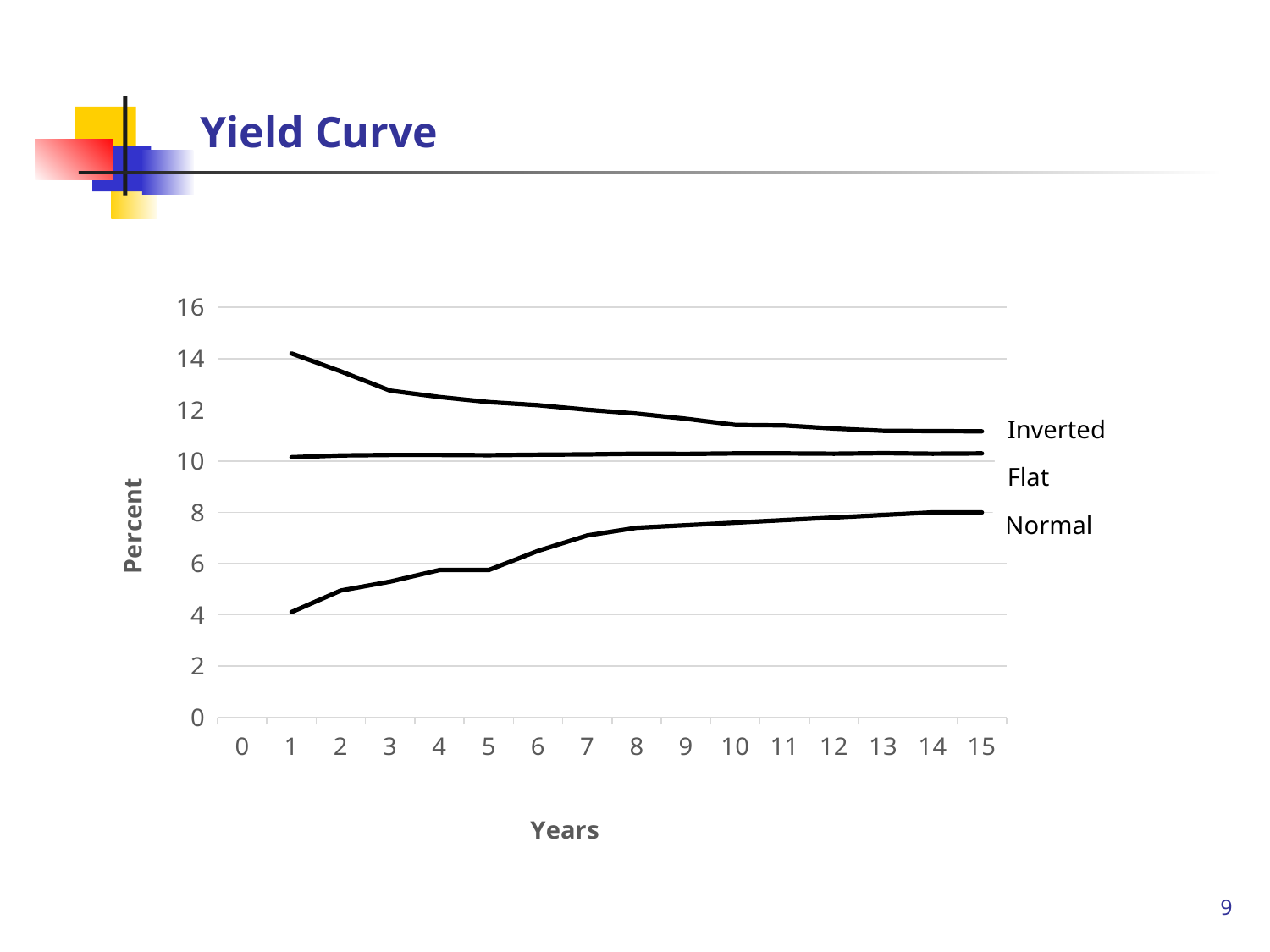
Is the value of the Inverted series at year 1 greater or less than 12? greater At year 1, which series has the larger value, Inverted or Normal? Inverted Is the value of the Inverted series at year 15 greater or less than 10? greater Does the Inverted series rise or fall as the years increase? fall How many series are plotted on the chart? 3 Is the value of the Flat series at year 1 greater or less than 8? greater What is the label on the vertical axis of the chart? Percent What kind of chart is shown on the slide? line chart Does the Normal series rise or fall as the years increase? rise At year 15, which series has the larger value, Flat or Normal? Flat